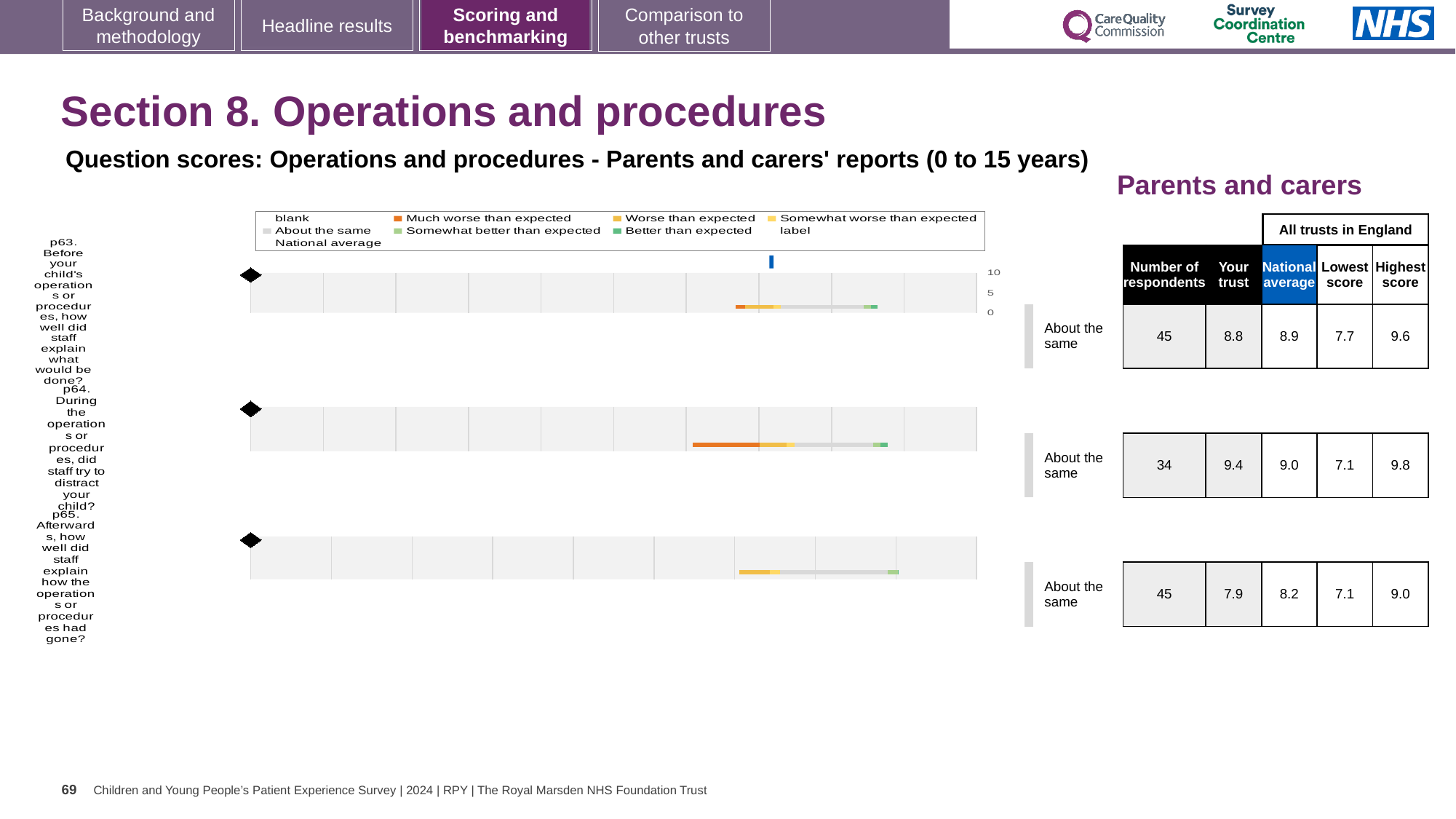
What benchmark category is shown for p65? About the same What is the national average score for p63 (Before your child's operations or procedures, how well did staff explain what would be done?)? 8.9 How many questions (charts) are shown on the slide? 3 How many respondents answered p64? 34 What is the 'Your trust' score for p64 (During the operations or procedures, did staff try to distract your child?)? 9.4 What is the lowest score among all trusts in England for p63? 7.7 What is the highest score among all trusts in England for p65 (Afterwards, how well did staff explain how the operations or procedures had gone?)? 9.0 For p63, which is larger: the 'Your trust' score or the national average? National average Which question has the lowest 'Your trust' score? p65 What kind of chart is used for each question on the slide? Bar chart Which question has the highest 'Your trust' score? p64 For p64, what is the difference between the 'Your trust' score and the national average? 0.4